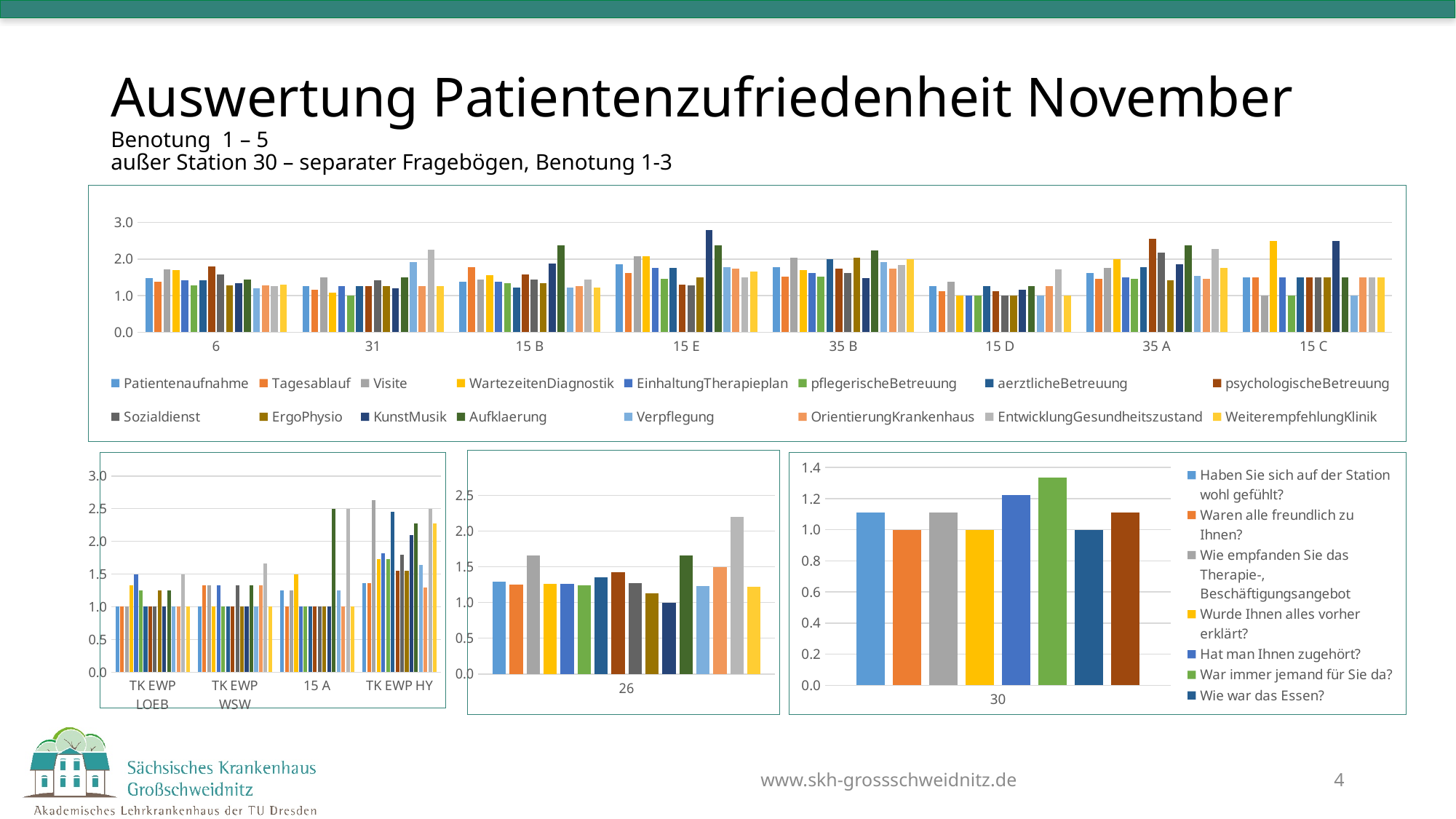
In the bottom-right chart (station 30), is the value for "War immer jemand für Sie da?" greater or less than 1.2? greater In the large top chart, how many series does the legend list? 16 In the large top chart, is the value for psychologischeBetreuung at station 35 A greater or less than 2.0? greater What kind of chart is the large chart at the top of the slide? bar chart In the large top chart, is the value for WeiterempfehlungKlinik at station 15 C greater or less than 2.0? less In the bottom-right chart (station 30), which series has the highest value? War immer jemand für Sie da? In the bottom-middle chart, what is the label of the single category on the x axis? 26 In the bottom-left chart, how many categories are shown on the x axis? 4 In the large top chart, how many stations (categories) are shown on the x axis? 8 In the bottom-right chart (station 30), how many series does the legend list? 7